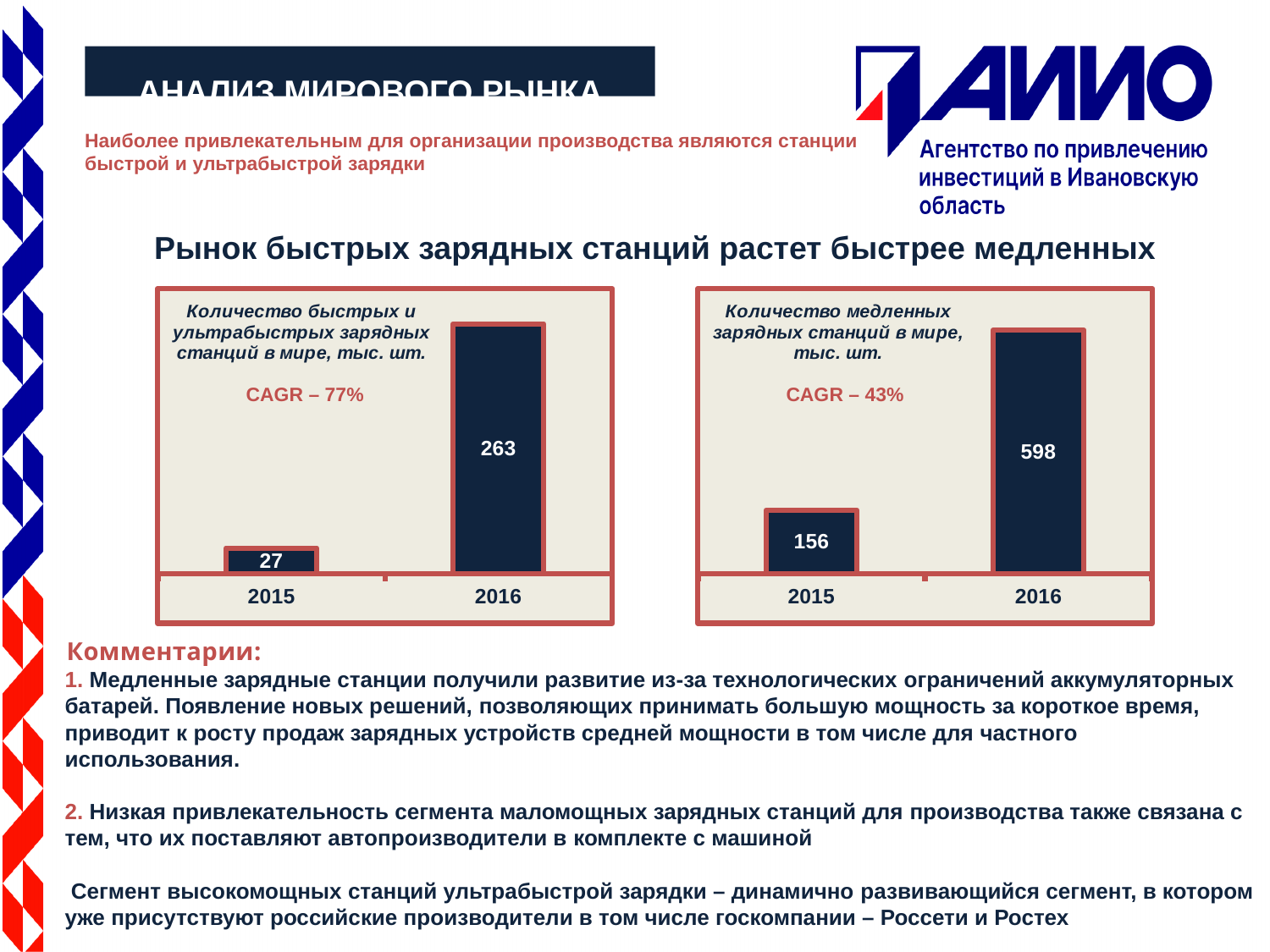
Which is larger: the 2016 value in the left chart (fast stations) or the 2016 value in the right chart (slow stations)? The right chart (slow stations), 598 In the right chart (slow charging stations), what is the difference between the 2016 and 2015 values? 442 In the left chart (fast and ultra-fast charging stations), what is the value for 2016? 263 What CAGR is stated in the left chart (fast and ultra-fast charging stations)? CAGR – 77% In the right chart (slow charging stations), which year has the lowest value? 2015 What type of chart is the right chart (slow charging stations)? Bar chart How many years are shown on the x axis of the left chart (fast and ultra-fast charging stations)? 2 In the right chart (slow charging stations), what is the value for 2015? 156 In the right chart (slow charging stations), what is the value for 2016? 598 In the left chart (fast and ultra-fast charging stations), what is the value for 2015? 27 In the left chart (fast and ultra-fast charging stations), what is the difference between the 2016 and 2015 values? 236 In the left chart (fast and ultra-fast charging stations), which year has the highest value? 2016